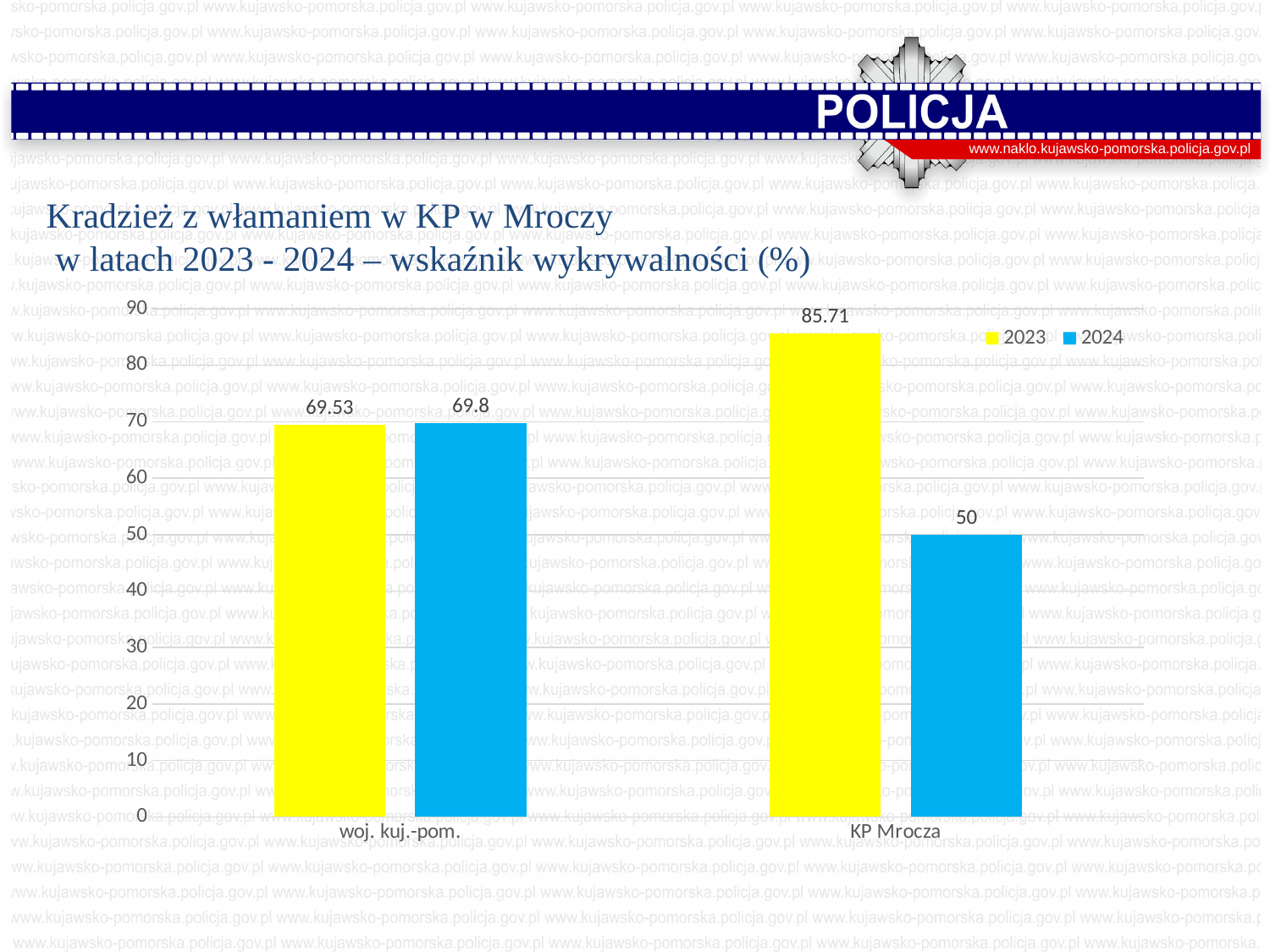
Which category has the lowest value in the 2024 series? KP Mrocza What is the value for woj. kuj.-pom. in 2023? 69.53 Which category has the highest value in the 2023 series? KP Mrocza Which is larger: the 2023 value for KP Mrocza or the 2023 value for woj. kuj.-pom.? KP Mrocza What is the value for KP Mrocza in 2023? 85.71 What is the value for KP Mrocza in 2024? 50 What kind of chart is shown on the slide? bar chart What is the difference between the 2023 and 2024 values for KP Mrocza? 35.71 Which colour represents the 2024 series? blue What is the difference between the 2023 values for KP Mrocza and woj. kuj.-pom.? 16.18 How many series does the legend list? 2 What is the value for woj. kuj.-pom. in 2024? 69.8